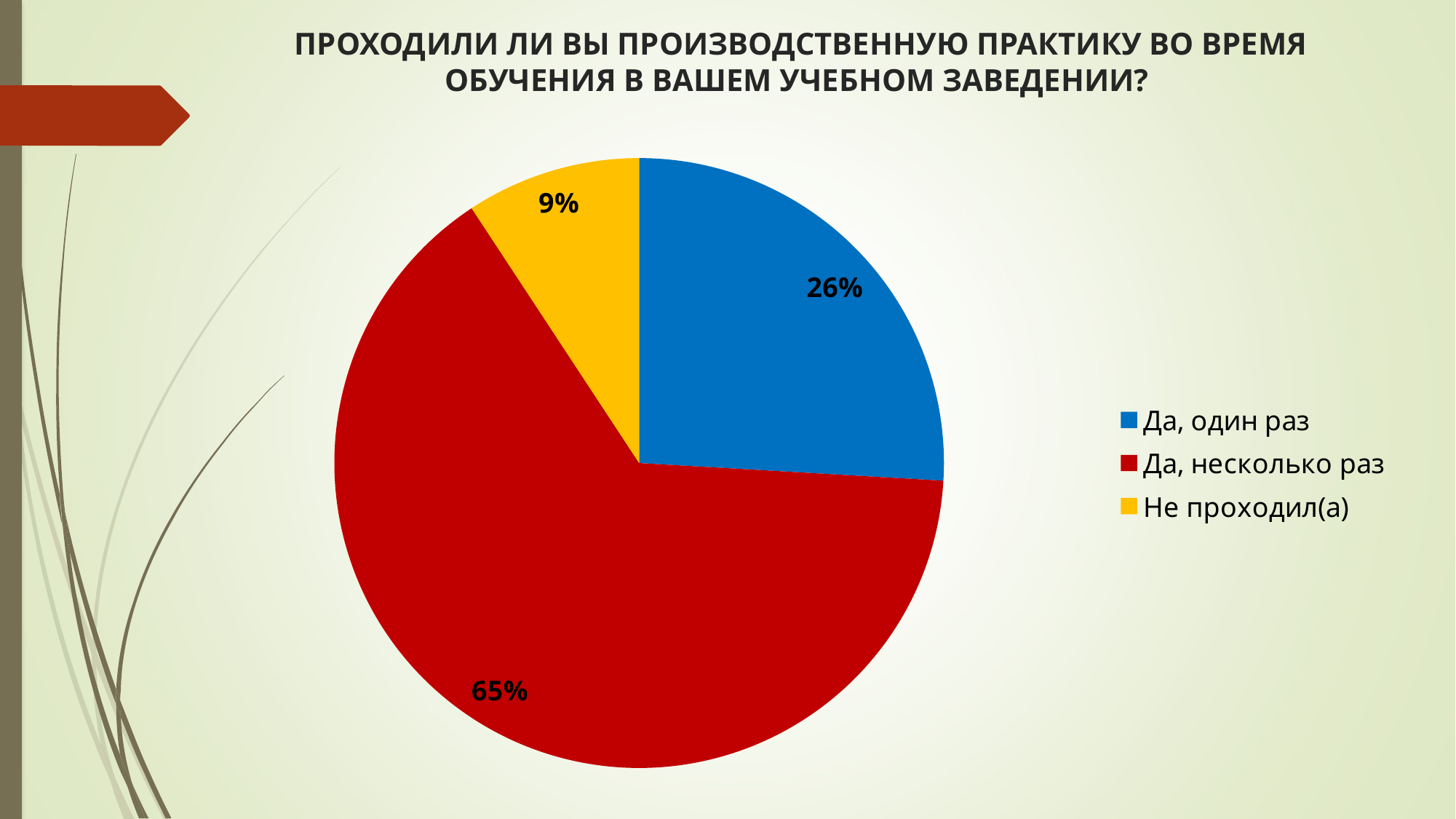
Which category has the smallest slice of the pie? Не проходил(а) What is the difference in percentage points between "Да, один раз" and "Не проходил(а)"? 17 Which is larger: the slice for "Да, один раз" or the slice for "Не проходил(а)"? Да, один раз What is the difference in percentage points between "Да, несколько раз" and "Да, один раз"? 39 What colour is the slice for "Да, несколько раз"? red What kind of chart is shown on the slide? pie chart What colour is the slice for "Не проходил(а)"? yellow What share of the pie does "Не проходил(а)" have? 9% What share of the pie does "Да, несколько раз" have? 65% Which category has the largest slice of the pie? Да, несколько раз What share of the pie does "Да, один раз" have? 26% How many categories does the pie chart have? 3